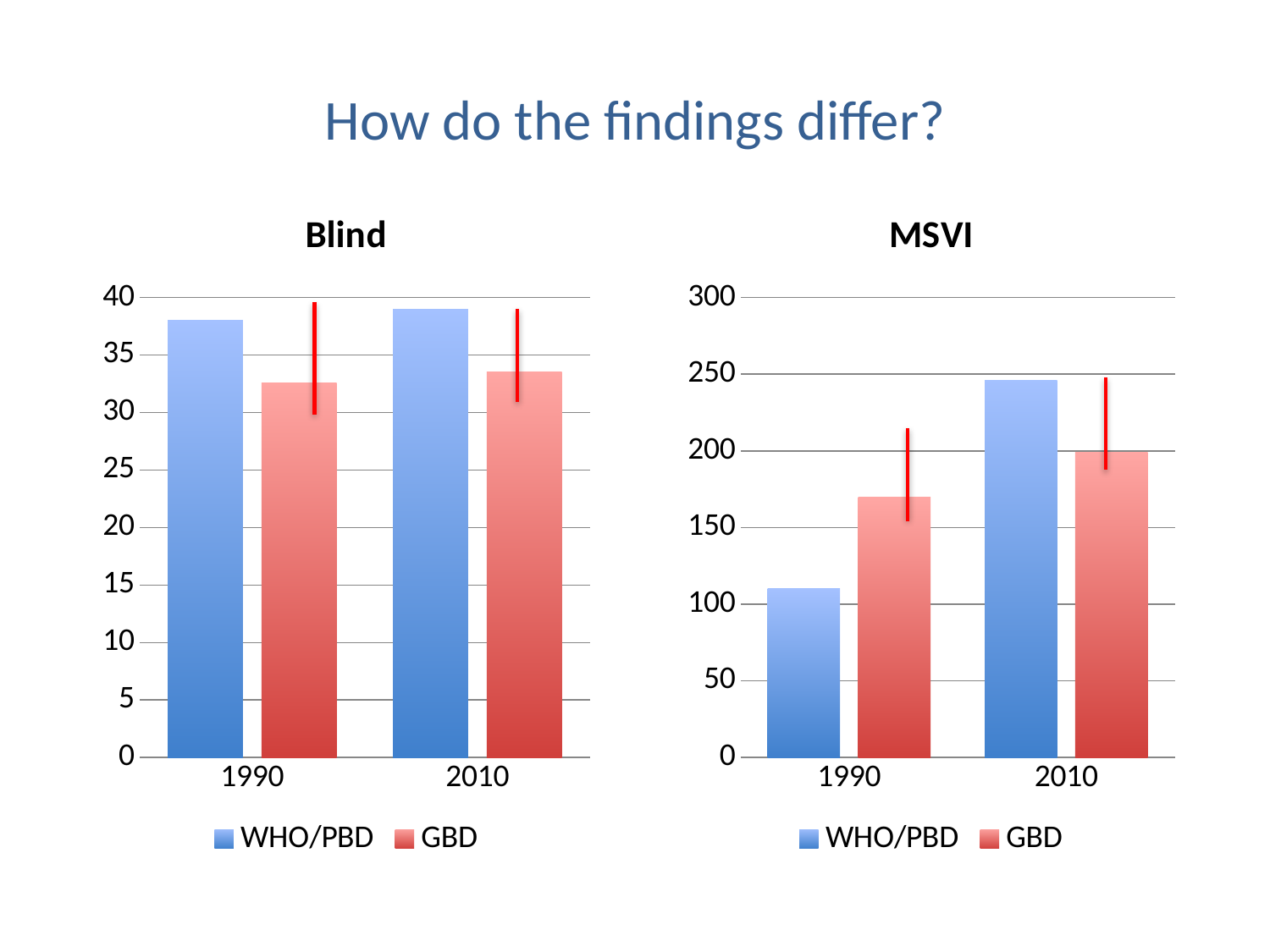
In the "MSVI" chart, which series has the larger value for 2010, WHO/PBD or GBD? WHO/PBD In the "MSVI" chart, is the WHO/PBD value for 1990 greater or less than 150? less In the "Blind" chart, is the GBD value for 2010 greater or less than 35? less How many categories are shown on the x axis of the "Blind" chart? 2 In the "Blind" chart, is the WHO/PBD value for 1990 greater or less than 35? greater In the "MSVI" chart, which series has the larger value for 1990, WHO/PBD or GBD? GBD In the "Blind" chart, which series has the larger value for 1990, WHO/PBD or GBD? WHO/PBD What kind of chart is the "Blind" chart? bar chart How many series does the legend of the "MSVI" chart list? 2 In the "MSVI" chart, which year has the highest WHO/PBD value? 2010 What colour are the GBD bars in the "Blind" chart? red In the "MSVI" chart, does the WHO/PBD series rise or fall from 1990 to 2010? rise